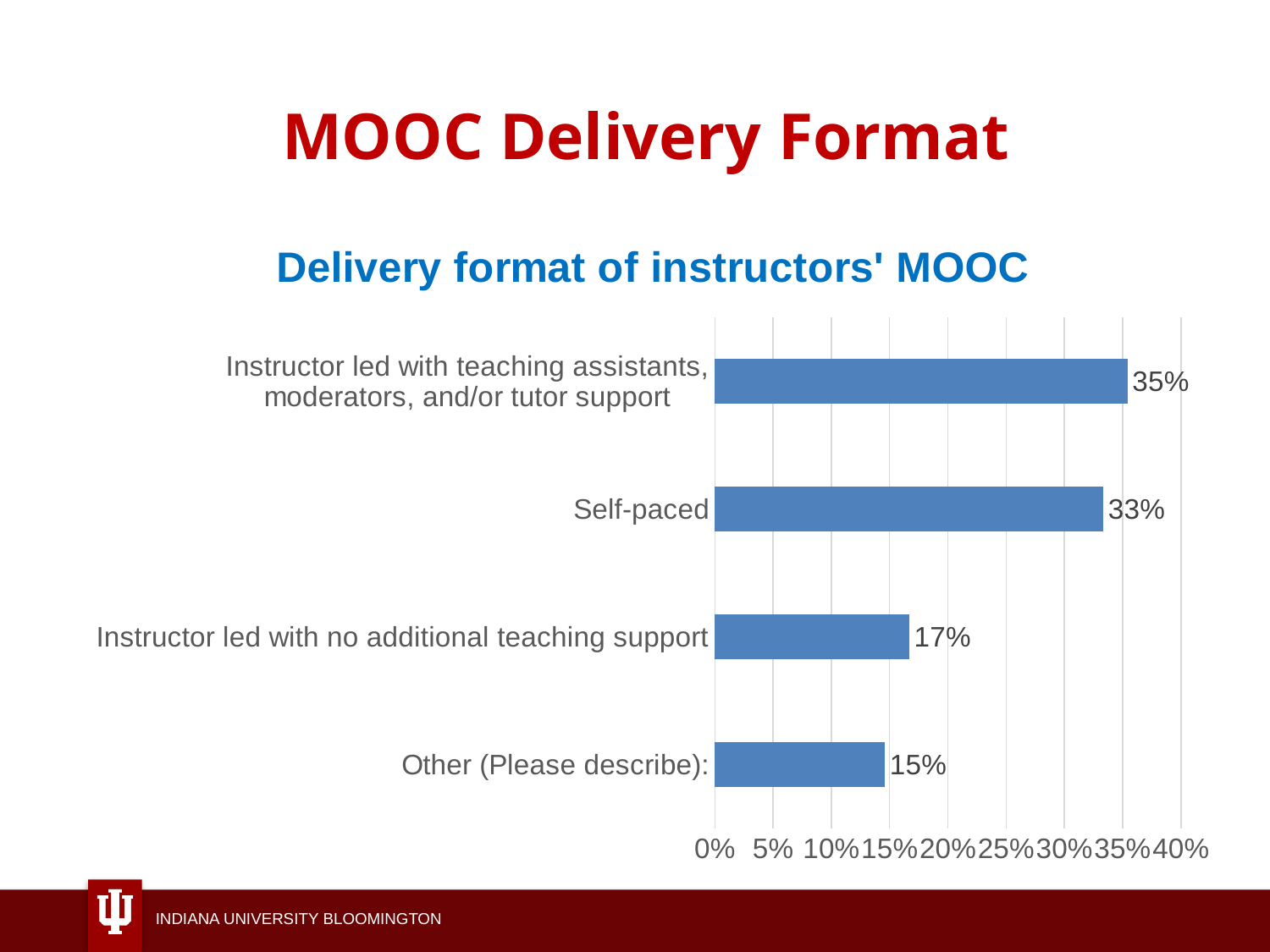
What is the value for 'Other (Please describe):'? 15% What kind of chart is shown on the slide? Bar chart What is the title of the chart? Delivery format of instructors' MOOC Which delivery format has the lowest percentage? Other (Please describe): What is the value for 'Instructor led with no additional teaching support'? 17% Which is larger: the value for 'Self-paced' or the value for 'Other (Please describe):'? Self-paced Which delivery format has the highest percentage? Instructor led with teaching assistants, moderators, and/or tutor support What percentage of instructors' MOOCs are self-paced? 33% What is the value for 'Instructor led with teaching assistants, moderators, and/or tutor support'? 35% Is the value for 'Instructor led with no additional teaching support' greater or less than 20%? less How many delivery format categories are shown in the chart? 4 What is the difference between the 'Self-paced' value and the 'Instructor led with no additional teaching support' value? 16%